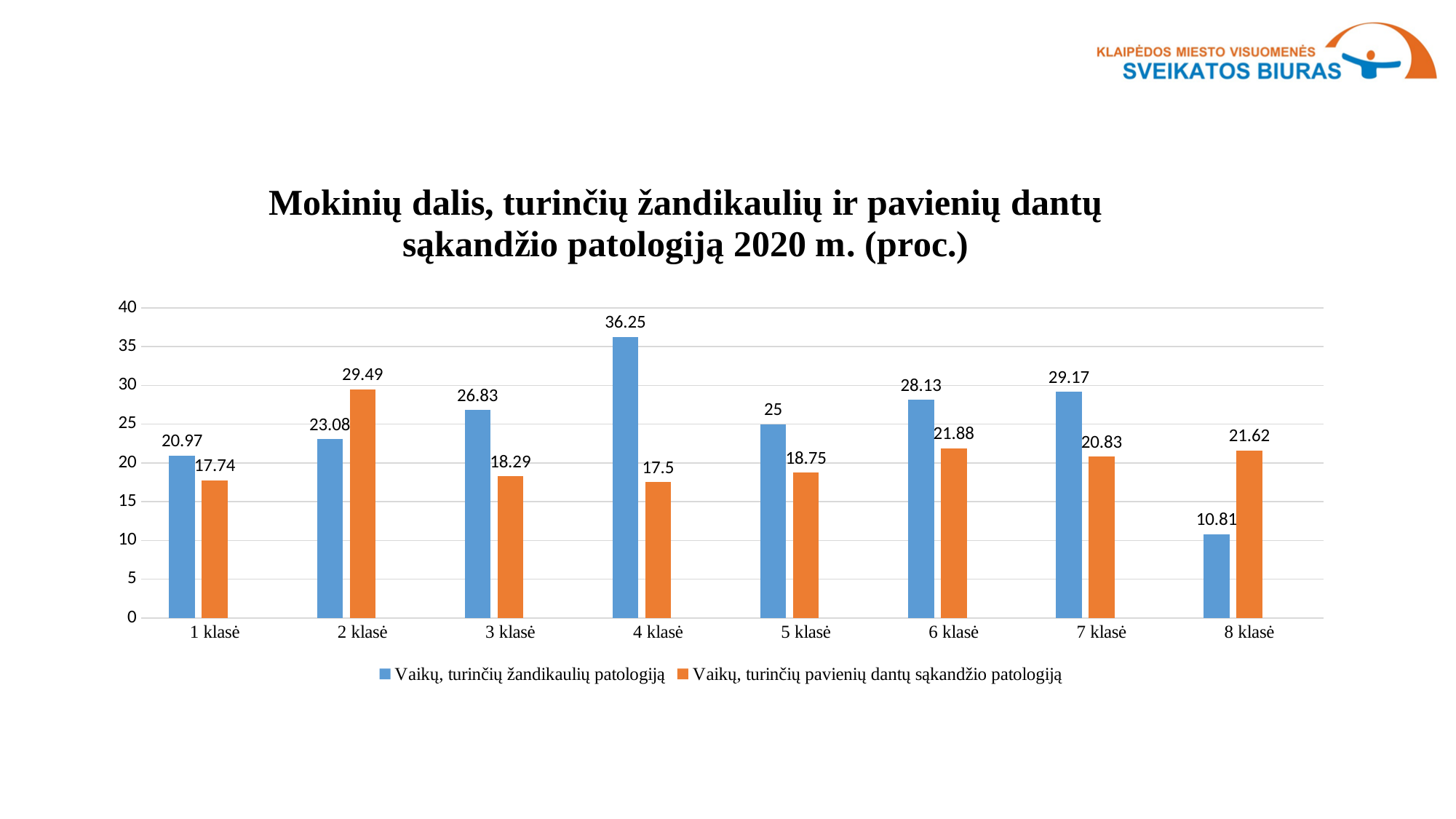
What is the title of the chart? Mokinių dalis, turinčių žandikaulių ir pavienių dantų sąkandžio patologiją 2020 m. (proc.) Which class has the lowest value in the series 'Vaikų, turinčių žandikaulių patologiją'? 8 klasė Is the value for 7 klasė in the series 'Vaikų, turinčių žandikaulių patologiją' greater or less than 25? greater For 2 klasė, which series has the larger value? Vaikų, turinčių pavienių dantų sąkandžio patologiją How many classes are shown on the x axis? 8 What is the value for 4 klasė in the series 'Vaikų, turinčių žandikaulių patologiją'? 36.25 What is the difference between the two series for 4 klasė? 18.75 What is the value for 8 klasė in the series 'Vaikų, turinčių pavienių dantų sąkandžio patologiją'? 21.62 Which class has the lowest value in the series 'Vaikų, turinčių pavienių dantų sąkandžio patologiją'? 4 klasė How many series does the legend list? 2 What kind of chart is shown on the slide? Bar chart Which class has the highest value in the series 'Vaikų, turinčių žandikaulių patologiją'? 4 klasė